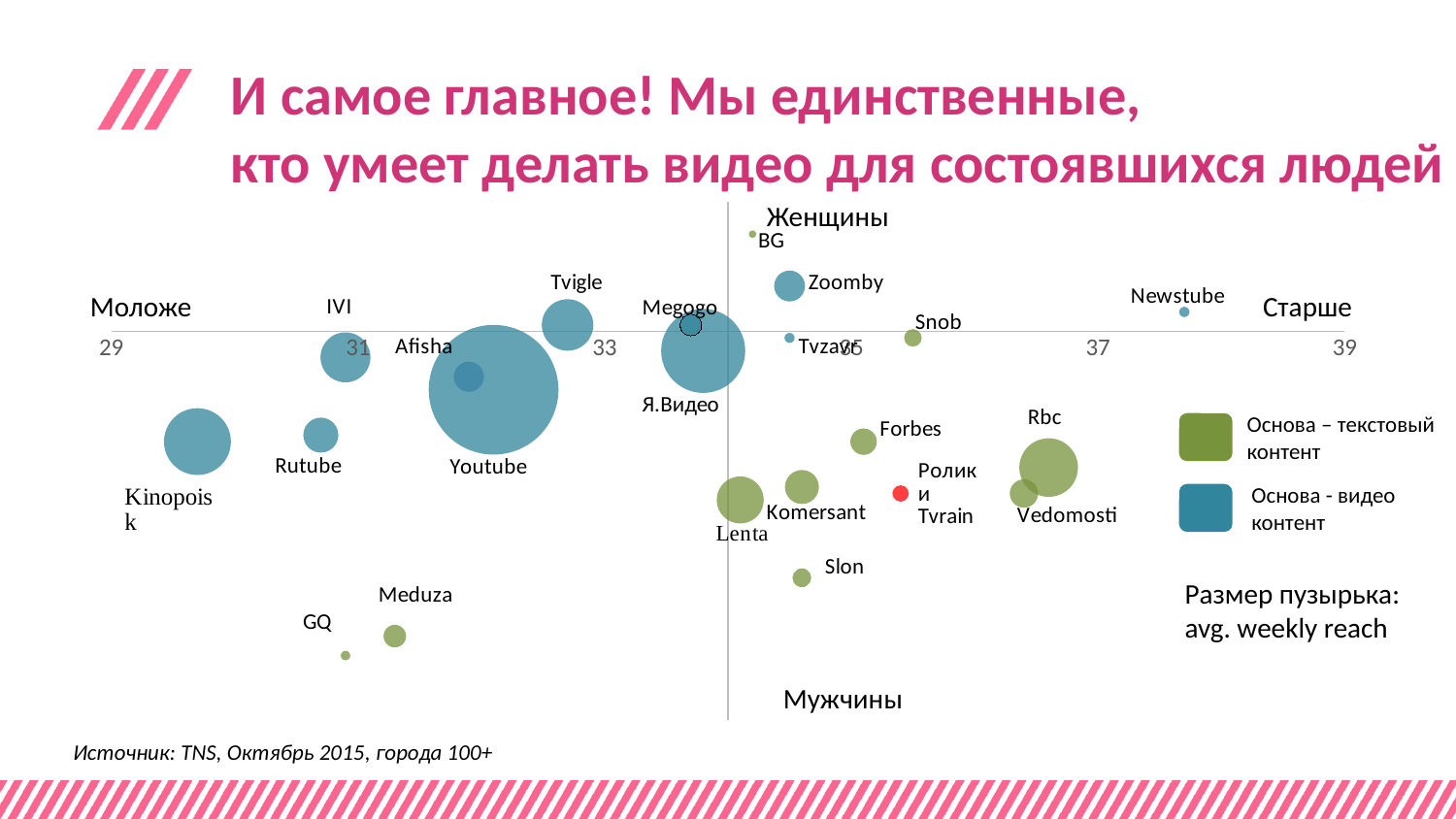
What kind of chart is shown on the slide? bubble chart Which site is placed higher on the chart (closer to 'Женщины'), BG or Slon? BG Is the horizontal (age) value for Newstube greater or less than 37? greater Is the horizontal (age) value for Youtube greater or less than 33? less Which bubble is larger, Youtube or Kinopoisk? Youtube Is the horizontal (age) value for Vedomosti greater or less than 35? greater Which site has the largest bubble on the chart? Youtube Which site is positioned furthest to the right (oldest audience) on the chart? Newstube Which site is positioned furthest to the left (youngest audience) on the chart? Kinopoisk According to the slide, what does the bubble size represent? avg. weekly reach How many entries does the colour legend list? 2